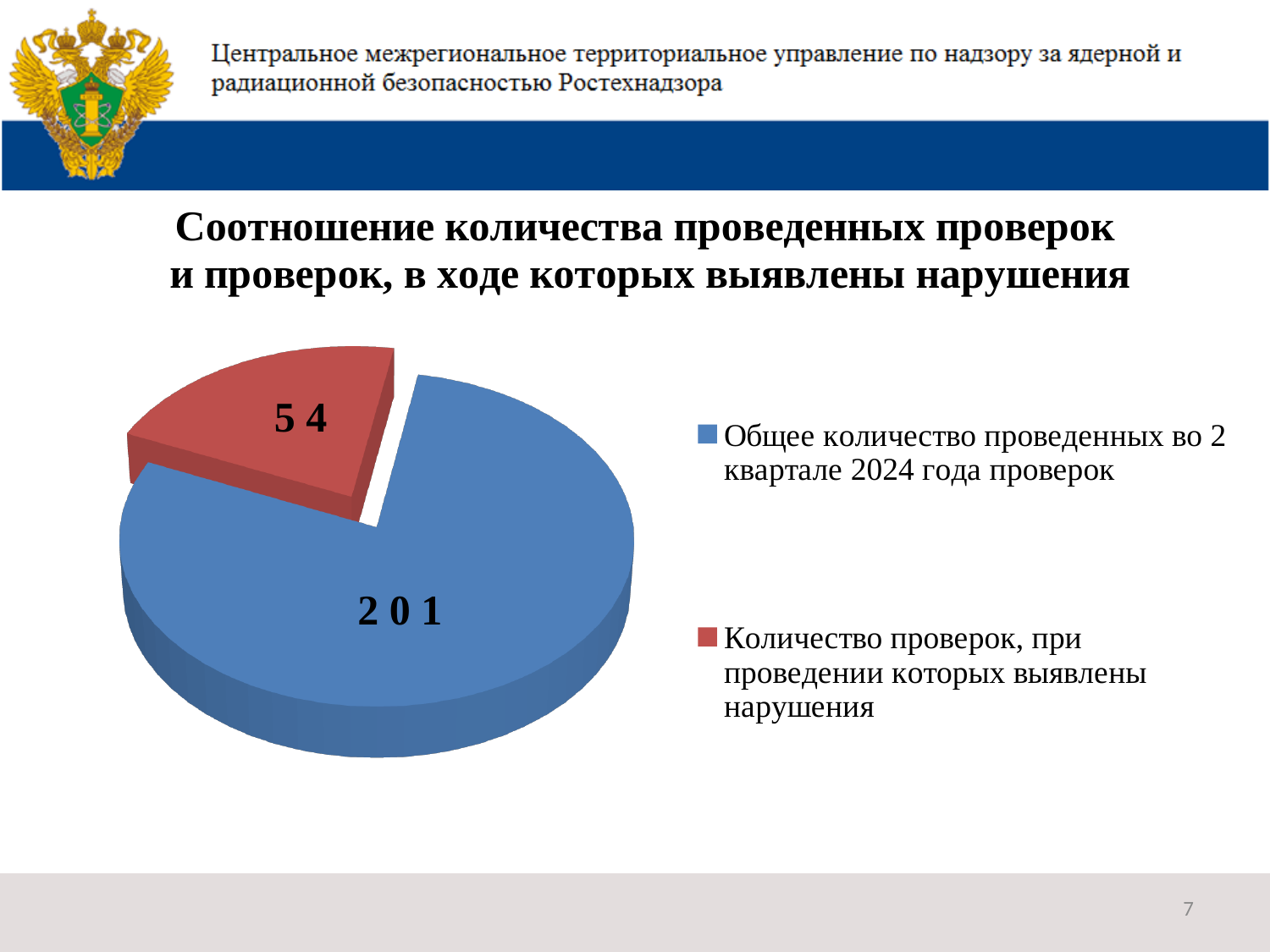
What colour is the slice representing inspections with violations? Red How many entries does the legend list? 2 What is the title of the chart on the slide? Соотношение количества проведенных проверок и проверок, в ходе которых выявлены нарушения Which is larger: the slice for total inspections or the slice for inspections with violations? Total inspections (Общее количество проведенных во 2 квартале 2024 года проверок) How many slices does the pie chart have? 2 Which category has the largest slice in the pie chart? Общее количество проведенных во 2 квартале 2024 года проверок What is the sum of the two values shown in the pie chart? 255 Which category has the smallest slice in the pie chart? Количество проверок, при проведении которых выявлены нарушения What is the difference between the total number of inspections (201) and the number of inspections with violations (54)? 147 What is the value of the slice for 'Общее количество проведенных во 2 квартале 2024 года проверок'? 201 What kind of chart is shown on the slide? Pie chart What is the value of the slice for 'Количество проверок, при проведении которых выявлены нарушения'? 54